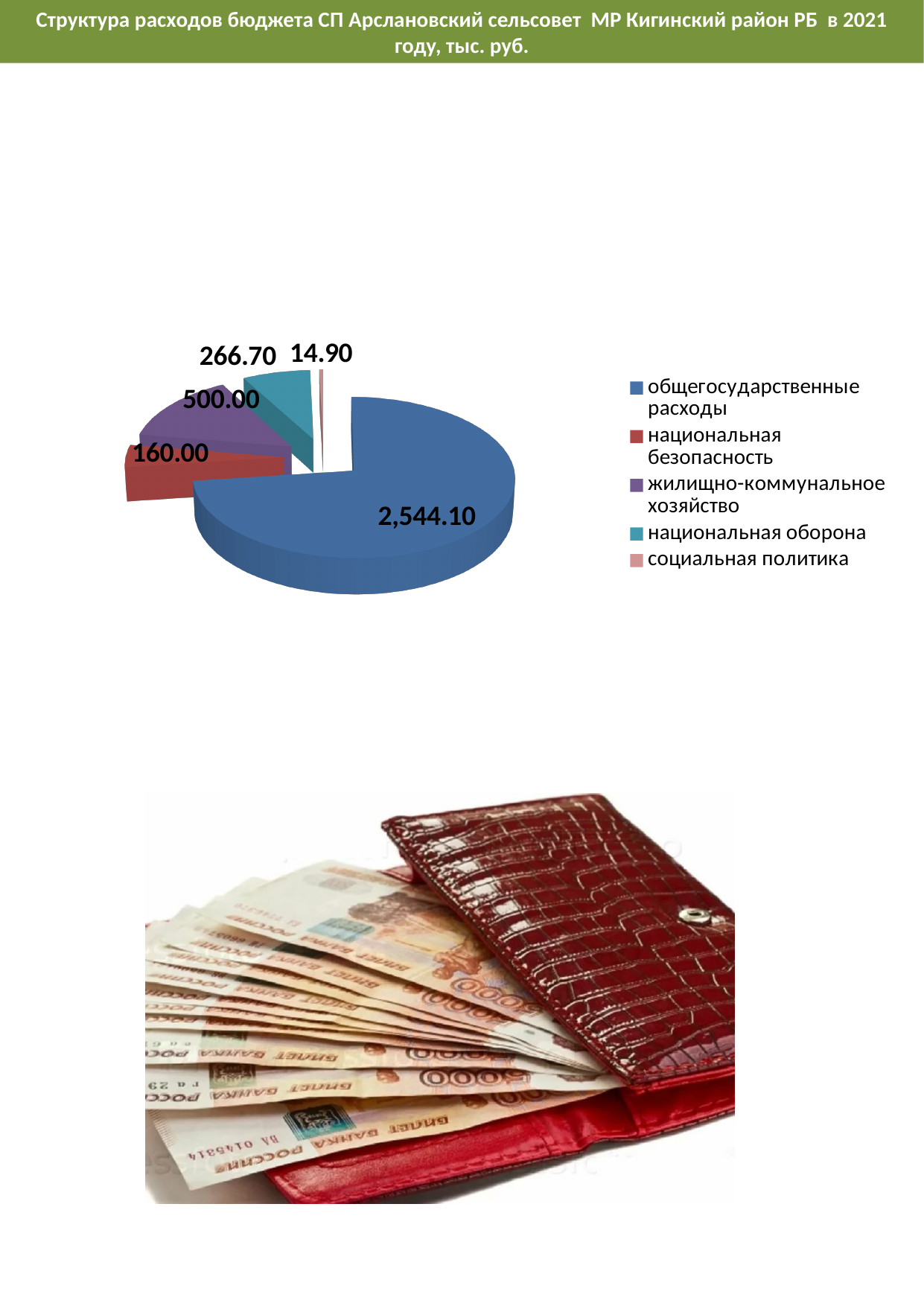
What is the difference between общегосударственные расходы and жилищно-коммунальное хозяйство? 2,044.10 What is the difference between национальная оборона and национальная безопасность? 106.70 What type of chart is shown on the slide? pie chart What is the value for национальная оборона? 266.70 What is the value for жилищно-коммунальное хозяйство? 500.00 What is the value for социальная политика? 14.90 Which category has the largest slice of the pie? общегосударственные расходы Which category has the smallest slice of the pie? социальная политика What is the value for общегосударственные расходы? 2,544.10 How many categories does the legend list? 5 What is the value for национальная безопасность? 160.00 Which is larger, жилищно-коммунальное хозяйство or национальная оборона? жилищно-коммунальное хозяйство